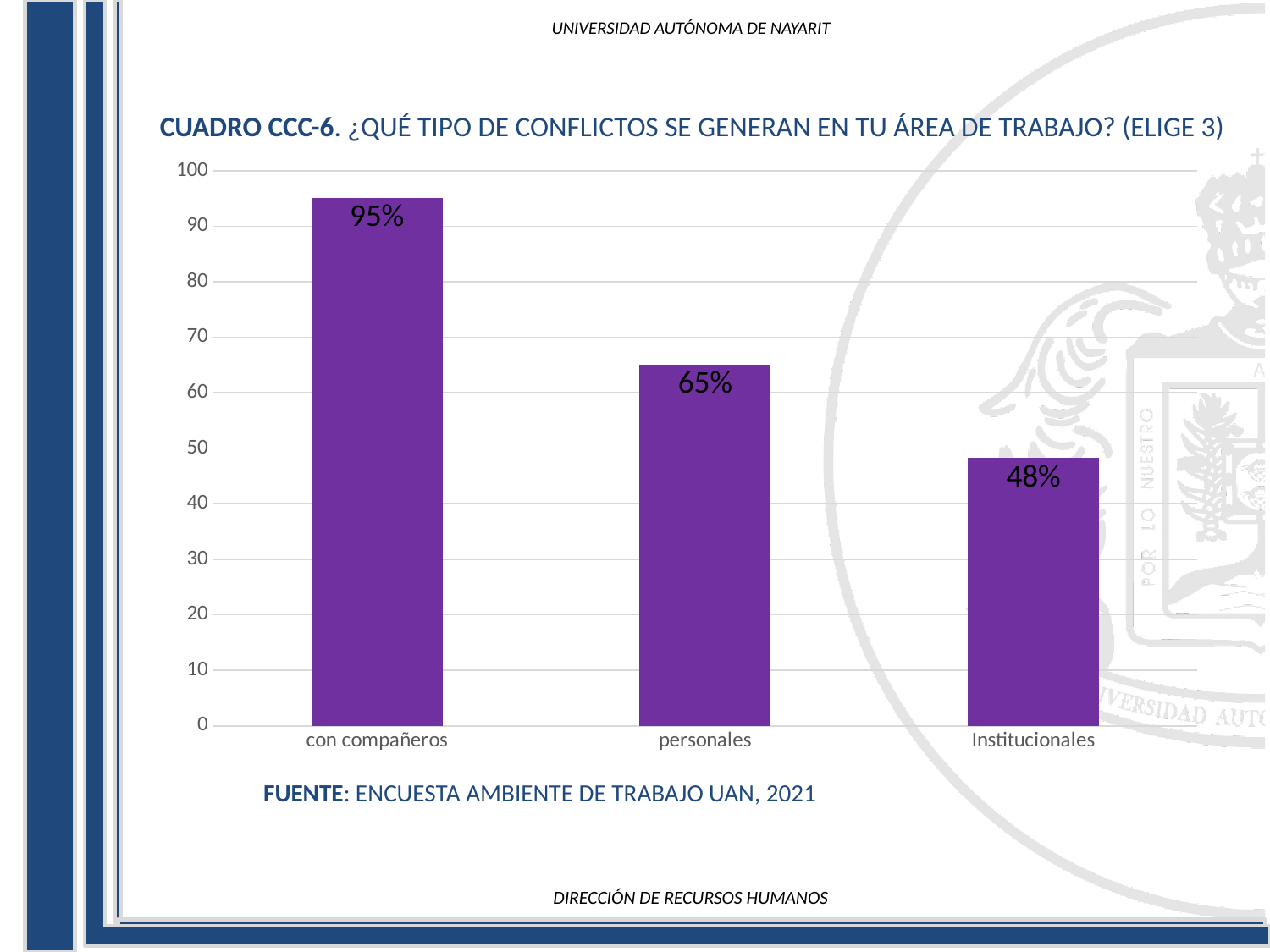
What is the value for personales? 65% What is the difference between the values for con compañeros and personales? 30% Is the value for Institucionales greater or less than 50? less Which category has the highest value? con compañeros Do the values rise or fall from left to right along the x axis? fall What is the value for con compañeros? 95% Which is larger, the value for personales or the value for Institucionales? personales What kind of chart is shown on the slide? bar chart Which category has the lowest value? Institucionales What is the value for Institucionales? 48% What is the difference between the values for personales and Institucionales? 17% How many categories are shown in the chart? 3